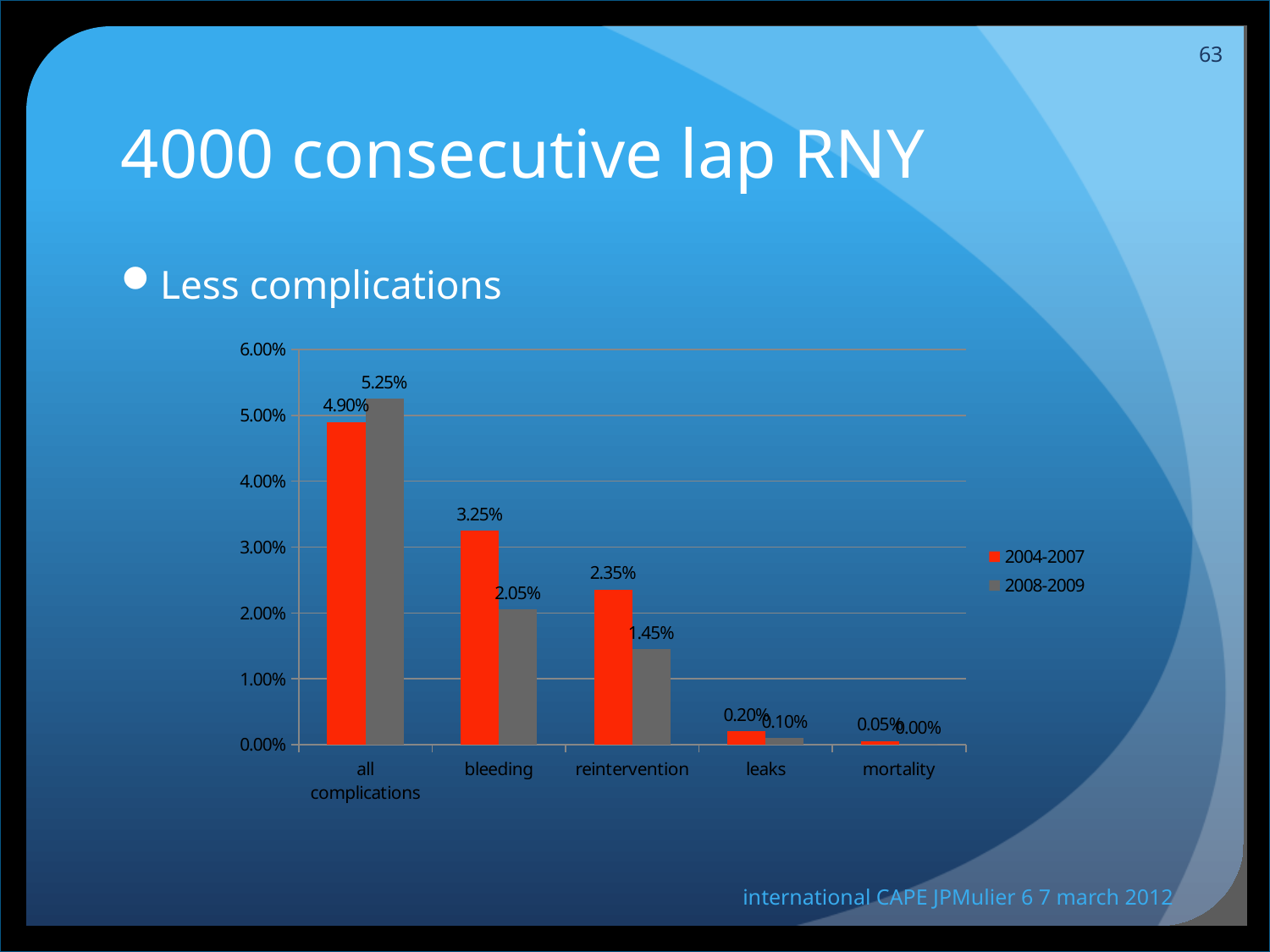
Which colour represents the 2004-2007 series in the legend? red What is the value for bleeding in the 2004-2007 series? 3.25% Which category has the highest value in the 2004-2007 series? all complications What is the value for reintervention in the 2008-2009 series? 1.45% What kind of chart is shown on the slide? bar chart How many series does the legend list? 2 For all complications, which series has the larger value, 2004-2007 or 2008-2009? 2008-2009 What is the value for all complications in the 2008-2009 series? 5.25% Which category has the lowest value in the 2008-2009 series? mortality How many categories are shown on the x axis? 5 What is the value for mortality in the 2004-2007 series? 0.05% What is the difference between the 2004-2007 and 2008-2009 values for bleeding? 1.20%